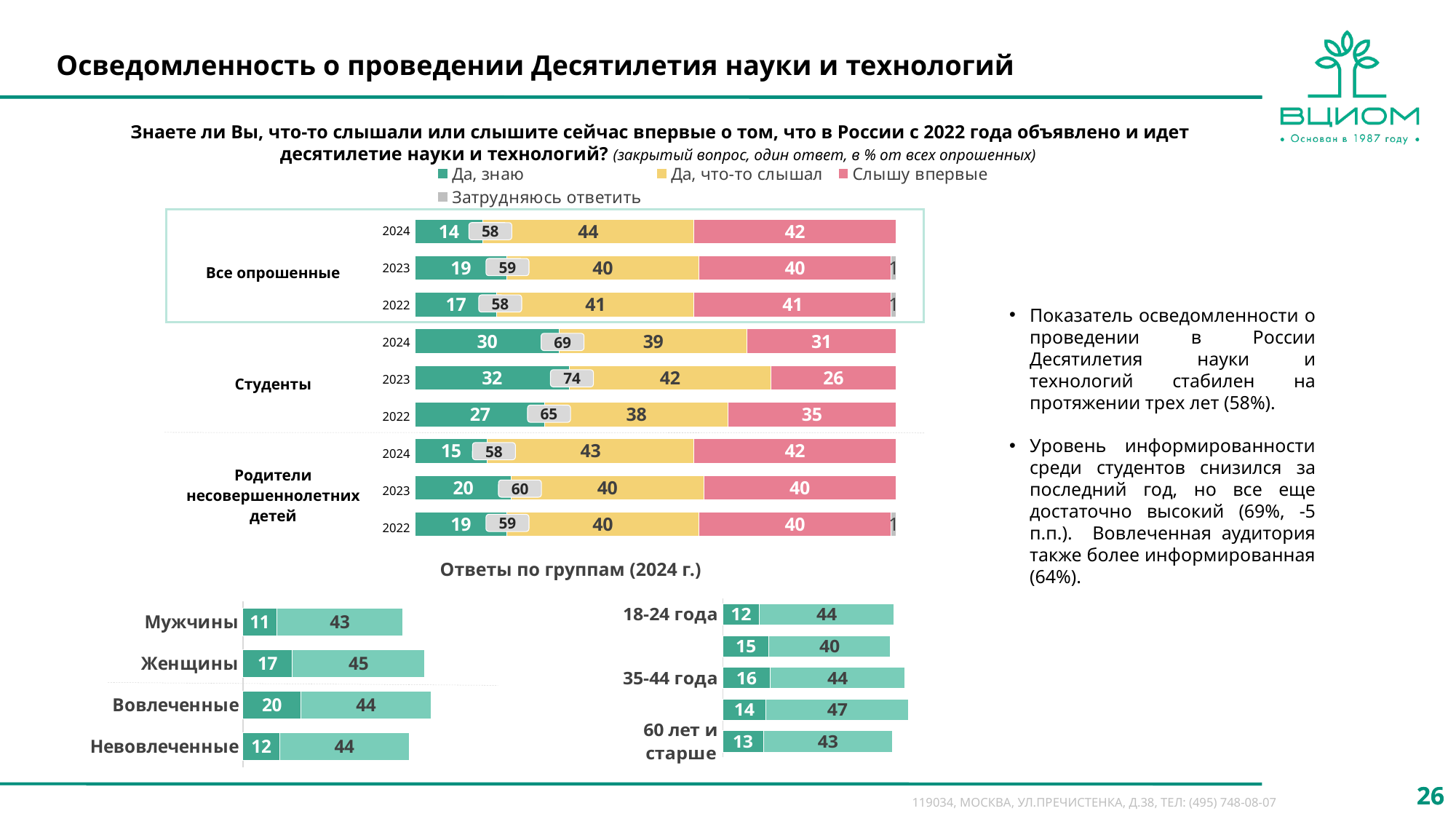
In the bottom-left chart 'Ответы по группам (2024 г.)', which category has the lowest 'Да, знаю' value? Мужчины In the bottom-left chart 'Ответы по группам (2024 г.)', which category has the highest 'Да, знаю' value? Вовлеченные In the bottom-left chart 'Ответы по группам (2024 г.)', how many categories are shown? 4 In the main stacked bar chart, what combined figure is shown in the grey box for 'Студенты' in 2023? 74 In the main stacked bar chart, what is the value of 'Слышу впервые' for 'Студенты' in 2023? 26 In the bottom-right chart by age group, what is the 'Да, знаю' value for '35-44 года'? 16 What kind of chart is the main chart showing 'Все опрошенные', 'Студенты' and 'Родители несовершеннолетних детей'? Stacked bar chart In the main stacked bar chart, what is the value of 'Да, знаю' for 'Все опрошенные' in 2024? 14 How many series does the legend of the main stacked bar chart list? 4 In the main stacked bar chart, what is the difference between the 'Да, знаю' value for 'Студенты' in 2024 and for 'Все опрошенные' in 2024? 16 In the main stacked bar chart, which group and year has the highest 'Да, знаю' value? Студенты, 2023 In the main stacked bar chart, what is the value of 'Да, что-то слышал' for 'Родители несовершеннолетних детей' in 2022? 40